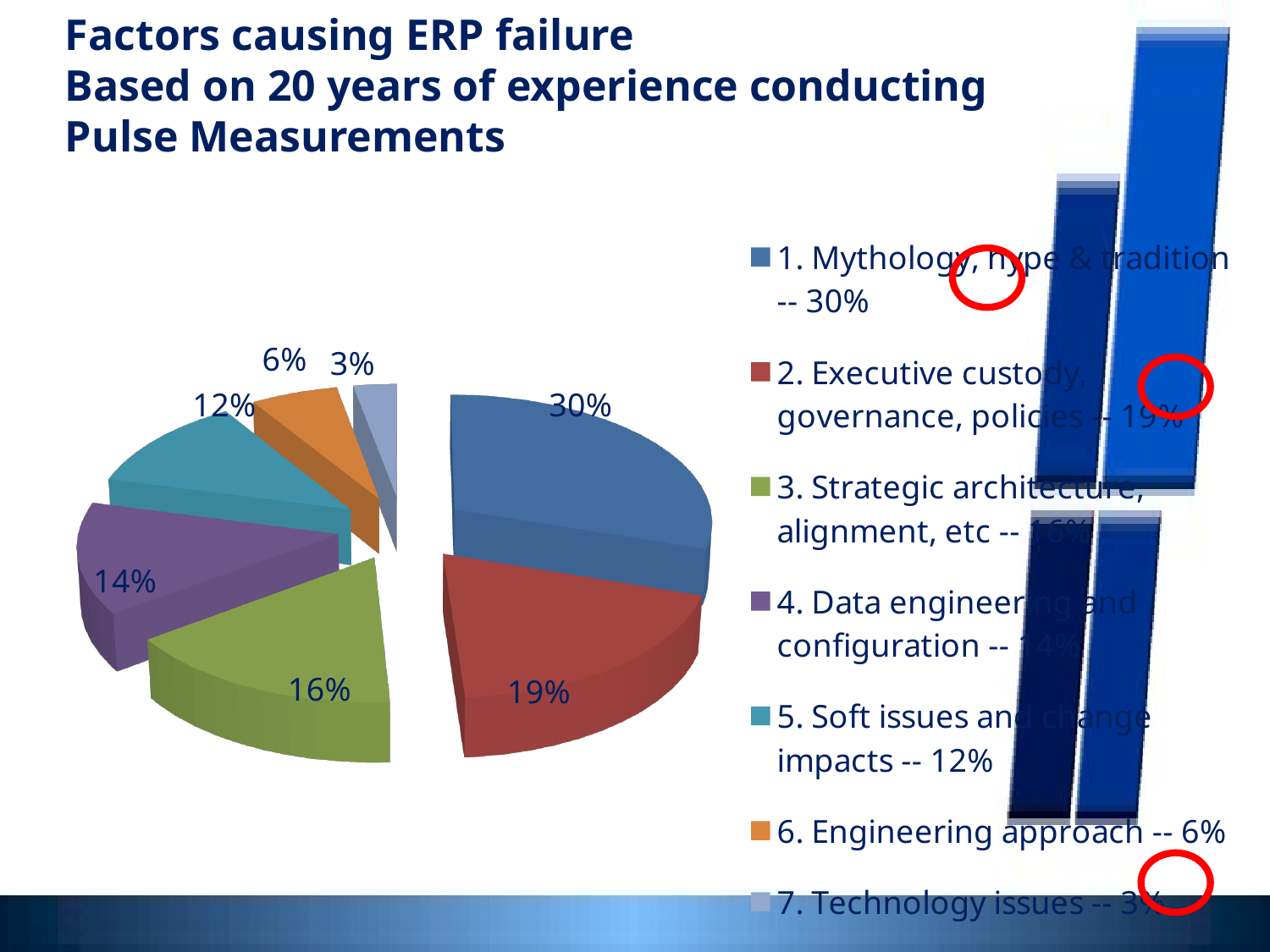
Which factor has the largest share of the pie? 1. Mythology, hype & tradition What percentage is shown for "Engineering approach"? 6% What percentage is shown for "Executive custody, governance, policies"? 19% What percentage is shown for "Soft issues and change impacts"? 12% What is the difference in percentage points between "Mythology, hype & tradition" and "Executive custody, governance, policies"? 11 Which is larger: the share for "Data engineering and configuration" or the share for "Soft issues and change impacts"? Data engineering and configuration What colour is the slice representing "Strategic architecture, alignment, etc"? green Which factor has the smallest share of the pie? 7. Technology issues How many slices does the pie chart have? 7 What share of the pie is attributed to "Mythology, hype & tradition"? 30% What is the combined share of "Engineering approach" and "Technology issues"? 9% What kind of chart is shown on the slide? pie chart